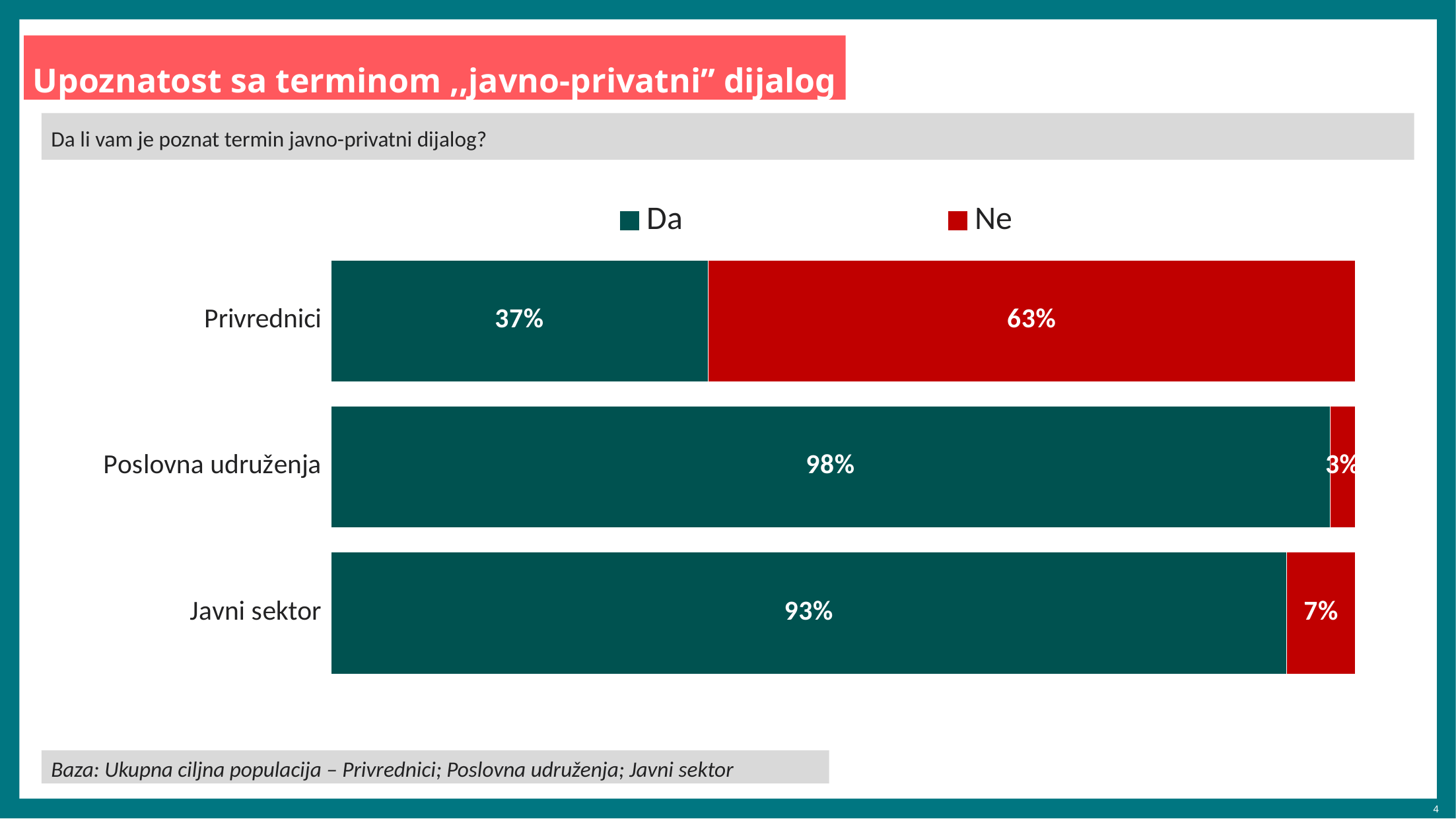
What percentage of Privrednici answered "Da"? 37% How many series does the legend list? 2 Which is larger: the "Da" value for Javni sektor or the "Da" value for Privrednici? Javni sektor What is the "Da" value for Javni sektor? 93% What is the "Ne" value for Javni sektor? 7% Which category has the highest "Da" share? Poslovna udruženja What kind of chart is shown on the slide? Stacked bar chart How many categories are shown in the chart? 3 What is the "Da" value for Poslovna udruženja? 98% What percentage of Privrednici answered "Ne"? 63% Which category has the lowest "Da" share? Privrednici What is the difference between the "Ne" values for Privrednici and Javni sektor? 56%